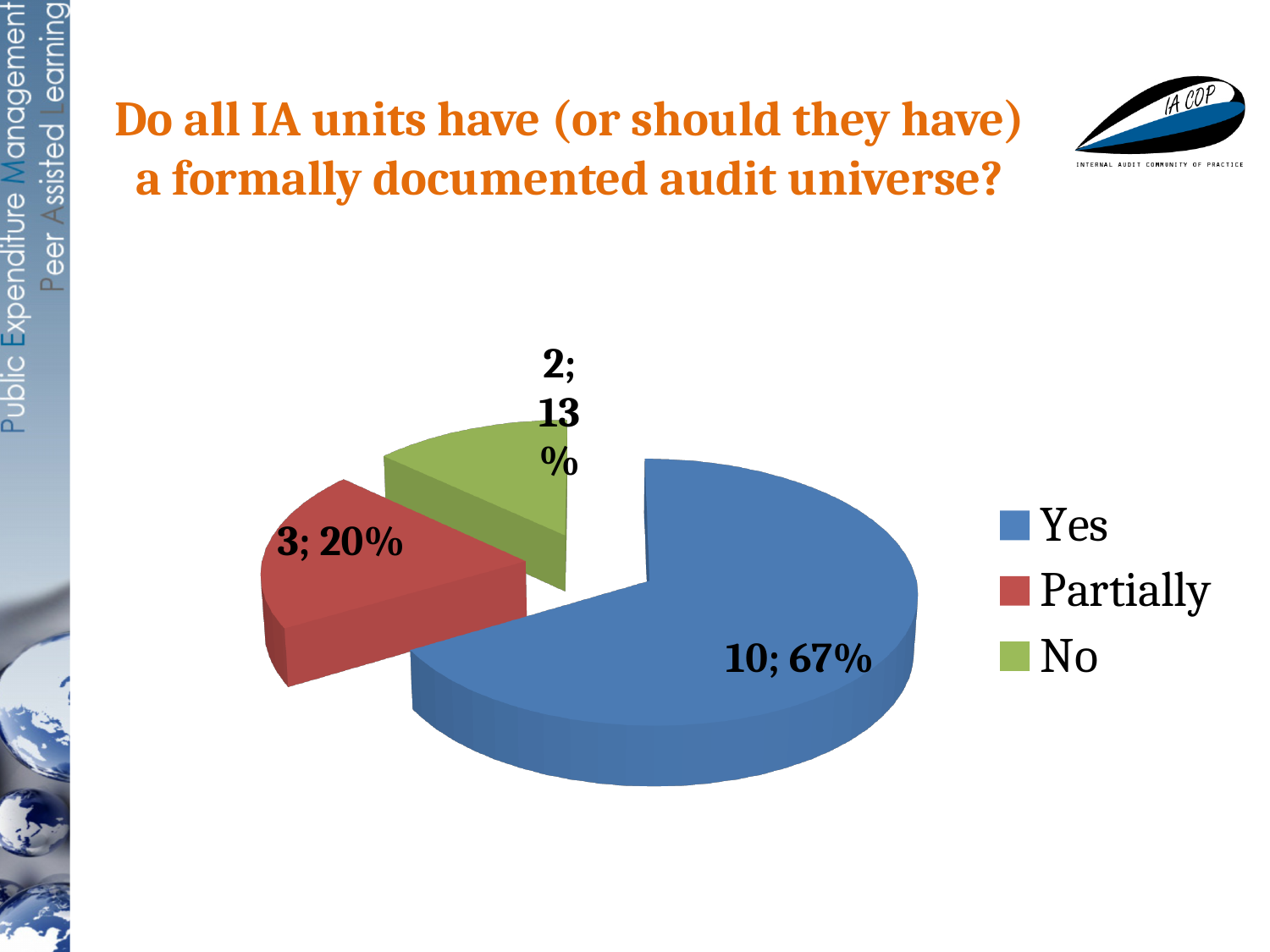
What is the difference in count between the "Yes" and "Partially" slices? 7 What percentage of the pie does the "Partially" slice represent? 20% Which slice is larger, "Partially" or "No"? Partially Which category has the largest slice? Yes What colour is the "Partially" slice? Red How many categories does the legend list? 3 What percentage of the pie does the "Yes" slice represent? 67% What kind of chart is shown on the slide? Pie chart How many responses are in the "No" slice? 2 Which category has the smallest slice? No How many responses are in the "Yes" slice? 10 What percentage of the pie does the "No" slice represent? 13%